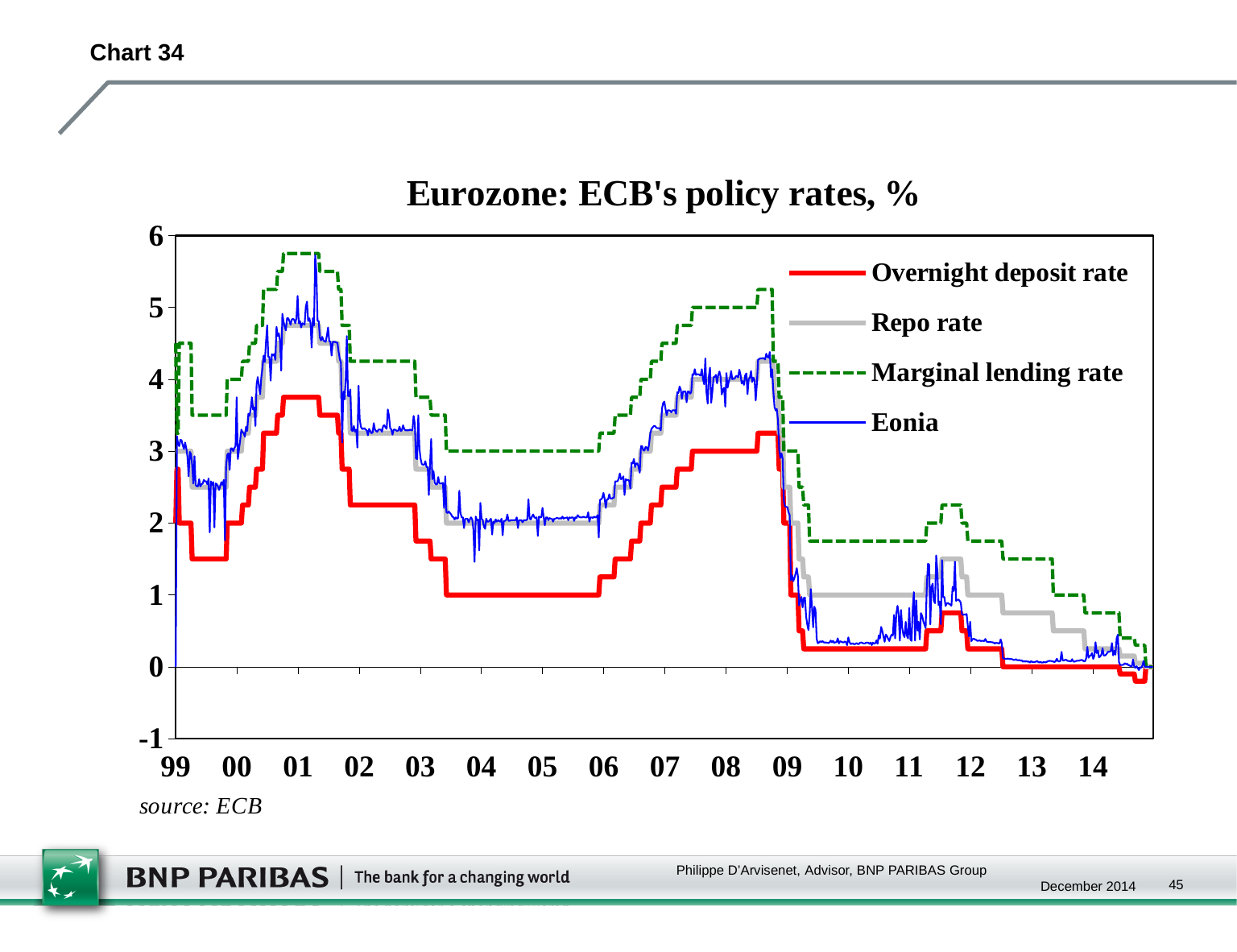
Which series reaches the highest value on the chart? Marginal lending rate What is the title of the chart? Eurozone: ECB's policy rates, % Which is higher in 2007, the Marginal lending rate or the Overnight deposit rate? Marginal lending rate Is the value of the Overnight deposit rate in 2004 greater or less than 2? less How many series does the legend list? 4 Is the value of the Overnight deposit rate at the end of 2014 greater or less than 0? less What kind of chart is shown on the slide? line chart Which series is drawn as a dashed line? Marginal lending rate How many year labels are shown on the x axis? 16 Is the value of the Repo rate in 2010 greater or less than 2? less Did the Repo rate rise or fall between 2008 and 2009? fall